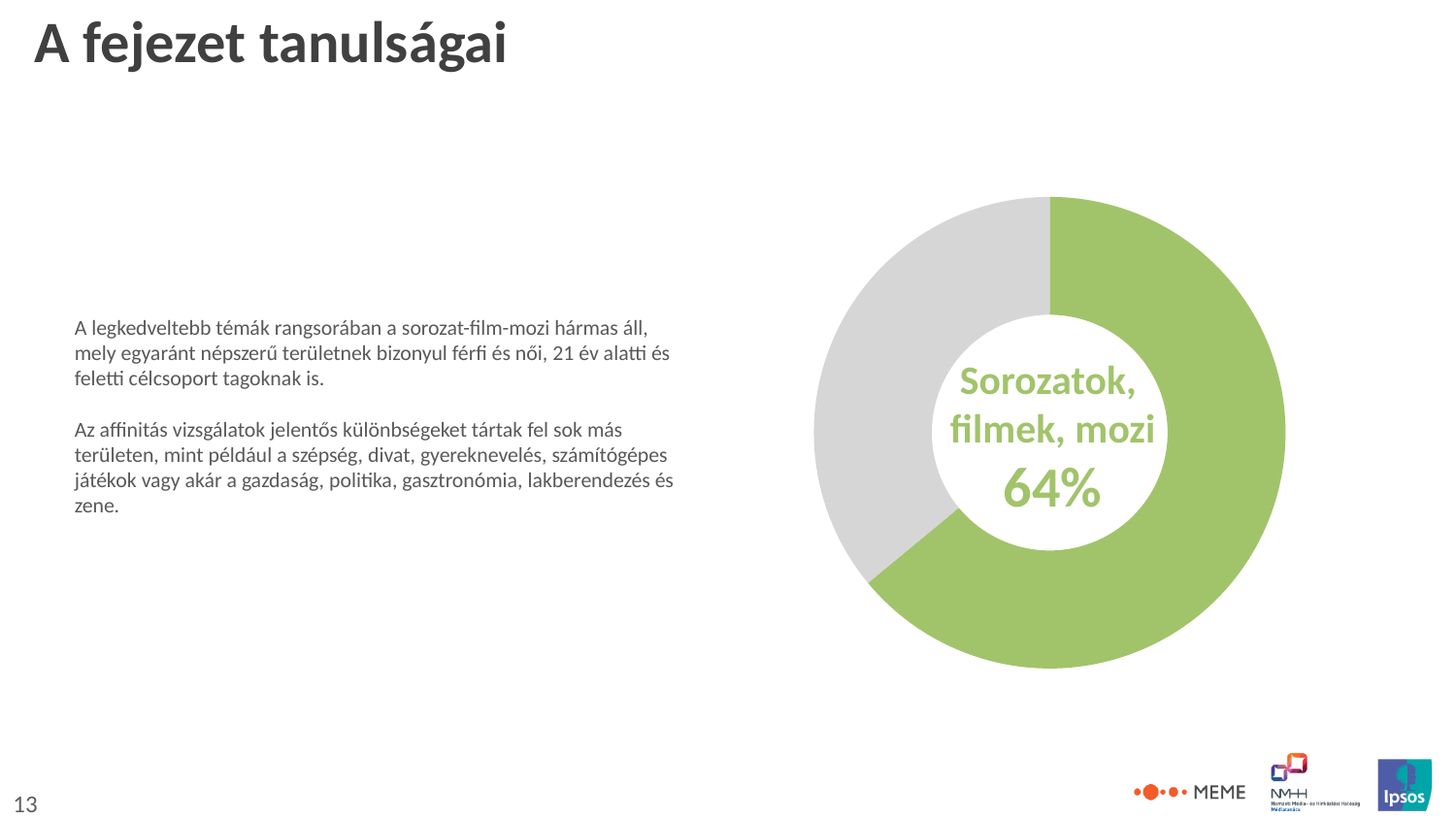
What value is printed in the centre of the donut chart? 64% What kind of chart is shown on the slide? Pie chart (donut) Does the 'Sorozatok, filmek, mozi' slice make up more than half of the donut chart? Yes Is the share for 'Sorozatok, filmek, mozi' greater or less than 50%? greater What colour is the 'Sorozatok, filmek, mozi' slice? Green Which slice is larger, the green slice or the grey slice? The green slice Which category is labelled on the donut chart? Sorozatok, filmek, mozi How many slices does the donut chart have? 2 What share of the pie does the 'Sorozatok, filmek, mozi' slice represent? 64%